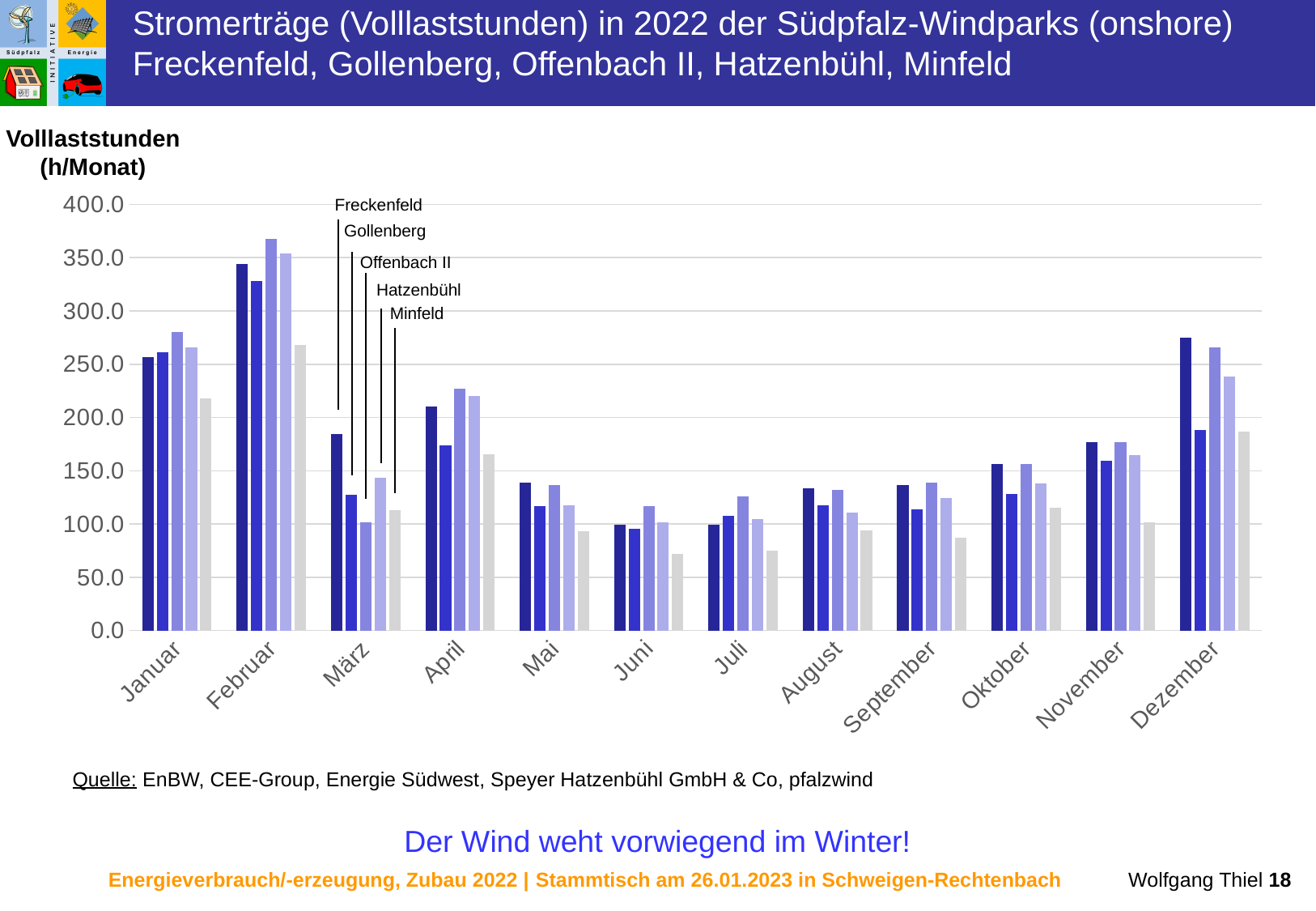
How many months are shown along the x axis of the chart? 12 What is the unit given for the y axis of the chart? h/Monat What kind of chart is shown on the slide? bar chart Do the Freckenfeld values rise or fall from Februar to Juni? fall Is the value for Freckenfeld in Februar greater or less than 300? greater How many wind parks (series) does the chart's legend list? 5 Is the value for Freckenfeld in März greater or less than 200? less Which is larger: the Offenbach II value in Februar or the Offenbach II value in Juni? Februar Is the value for Offenbach II in Februar greater or less than 350? greater Which month has the lowest Volllaststunden value for Gollenberg? Juni Which month has the highest Volllaststunden value for Offenbach II? Februar